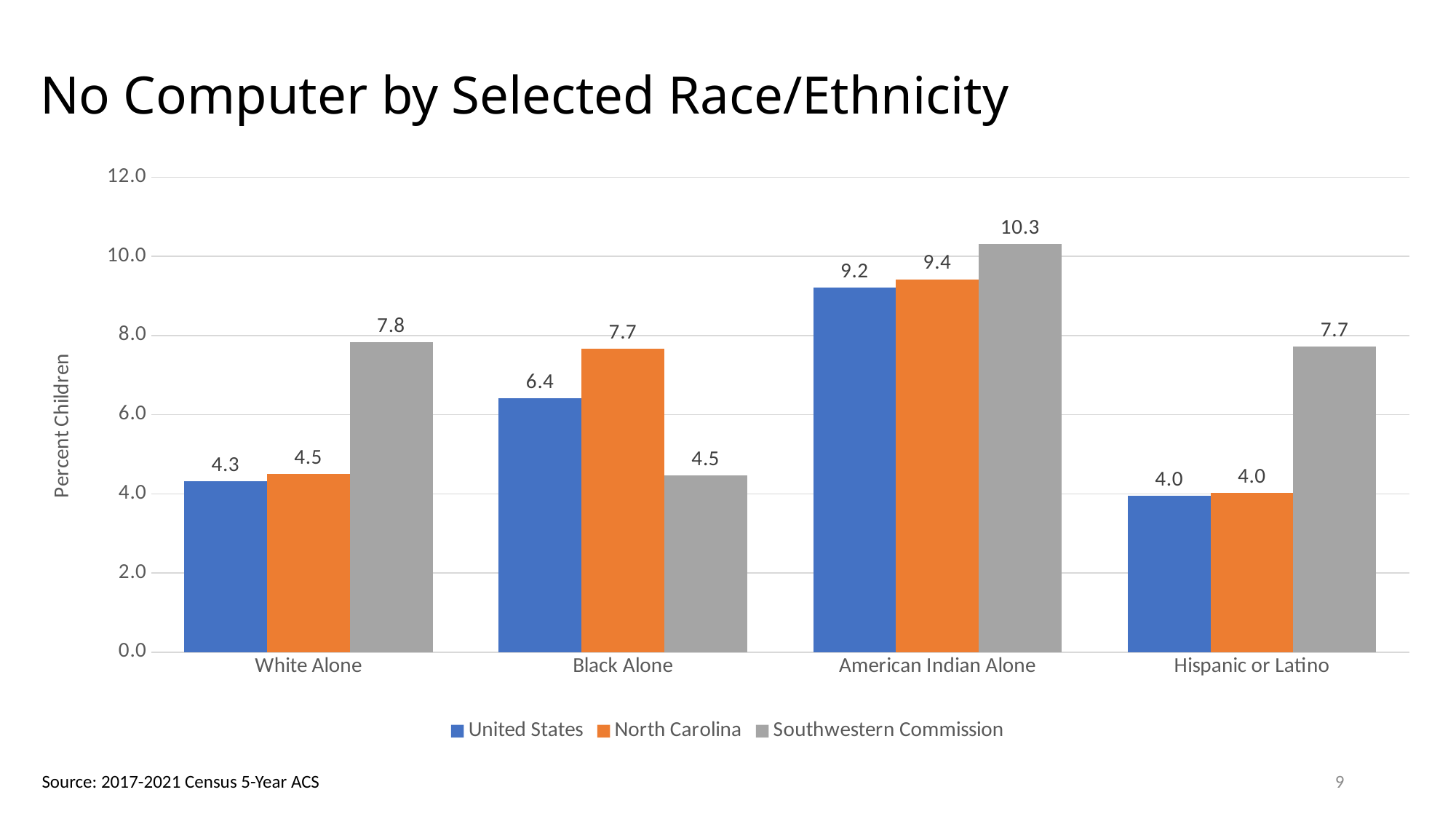
What is the label of the y axis? Percent Children Is the Southwestern Commission value for Hispanic or Latino greater or less than 6.0? greater What is the difference between the Southwestern Commission and United States values for White Alone? 3.5 Which is larger in the Black Alone category: North Carolina or Southwestern Commission? North Carolina Which category has the highest Southwestern Commission value? American Indian Alone How many series does the legend list? 3 How many race/ethnicity categories are shown on the x axis? 4 What kind of chart is shown on the slide? Bar chart What is the value for North Carolina in the Black Alone category? 7.7 What is the value for United States in the White Alone category? 4.3 What is the value for Southwestern Commission in the American Indian Alone category? 10.3 Which category has the lowest United States value? Hispanic or Latino